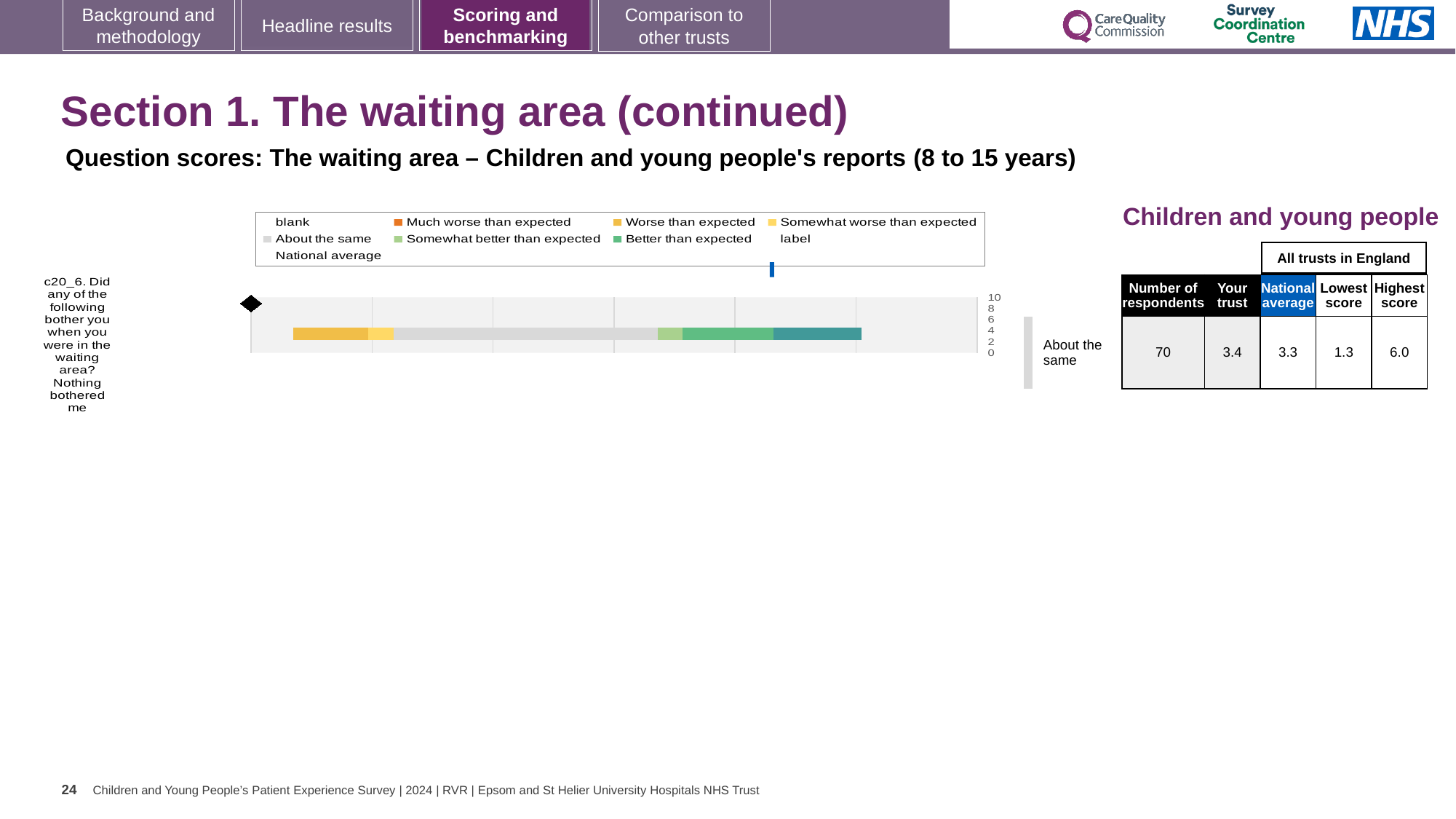
How many respondents answered question c20_6? 70 What is the 'Your trust' score for question c20_6? 3.4 How many entries does the chart legend list? 9 How many questions (categories) are plotted in the chart? 1 What kind of chart is shown on the slide? bar chart What is the difference between the trust's score and the national average for question c20_6? 0.1 Which legend entry is shown in orange? Much worse than expected Which is larger for question c20_6: the trust's score or the national average? the trust's score What benchmark category is shown next to the bar for question c20_6? About the same Which question is plotted in the chart? c20_6. Did any of the following bother you when you were in the waiting area? Nothing bothered me What is the national average score for question c20_6? 3.3 What is the difference between the highest and lowest scores across all trusts in England for question c20_6? 4.7